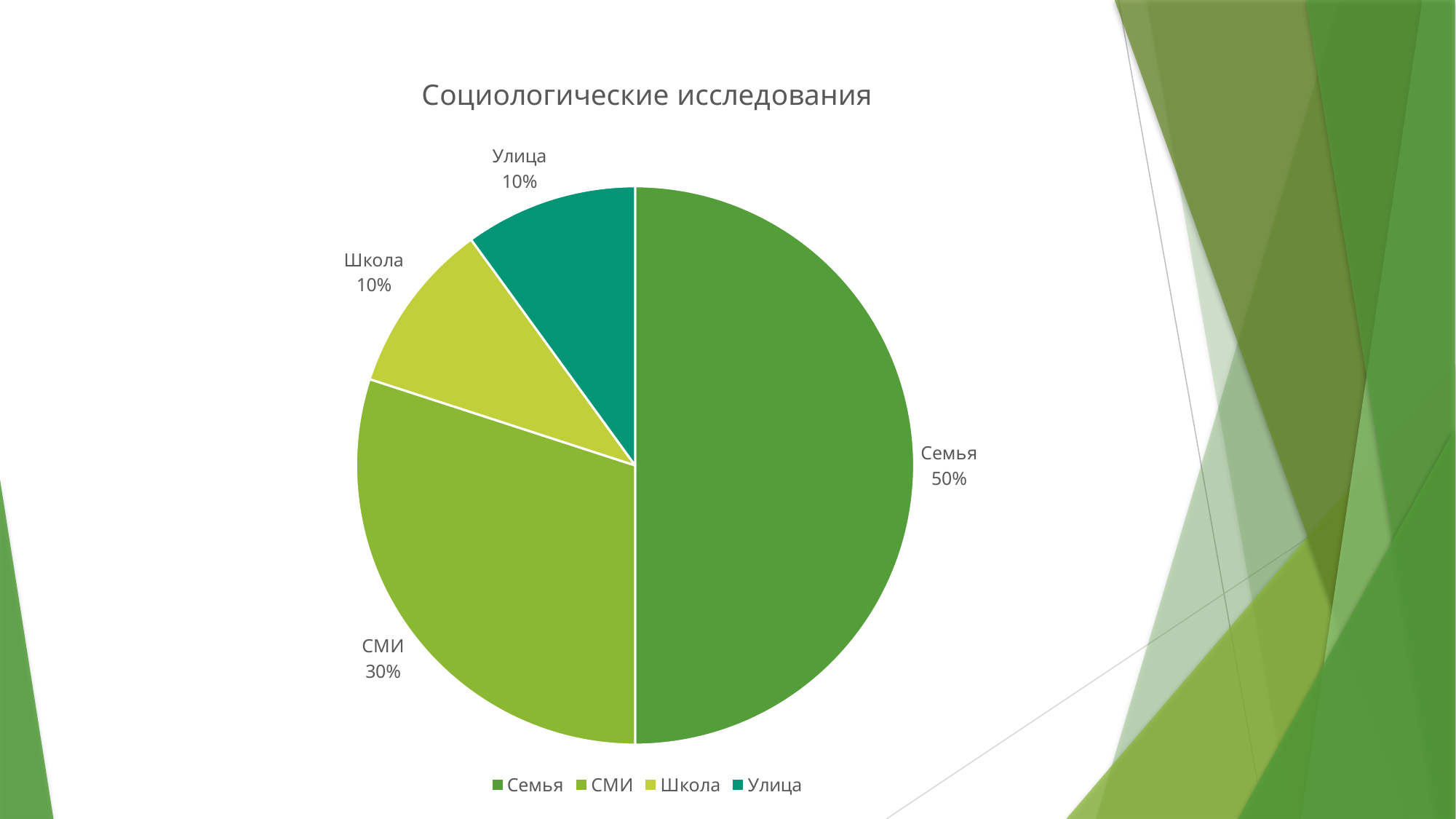
What is the combined share of Школа and Улица? 20% What share of the pie does Улица have? 10% How many entries does the legend list? 4 What kind of chart is shown on the slide? pie chart What share of the pie does Семья have? 50% Which category has the largest slice of the pie? Семья Which is larger, the share of СМИ or the share of Школа? СМИ What share of the pie does СМИ have? 30% How many categories are shown in the pie chart? 4 What is the difference between the shares of Семья and СМИ? 20% What is the title of the chart? Социологические исследования